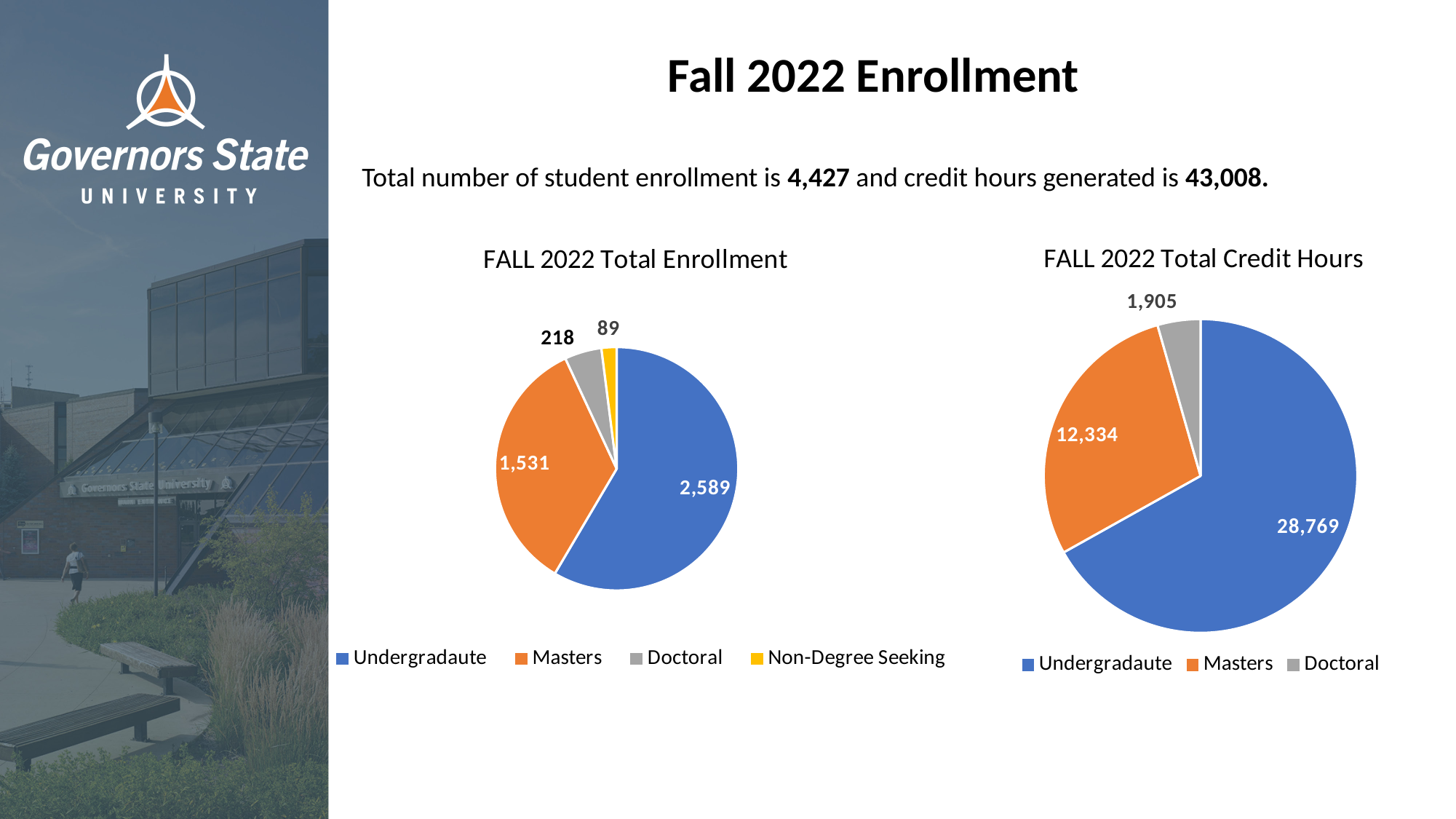
In the FALL 2022 Total Credit Hours chart, what is the value for Doctoral? 1,905 How many categories does the FALL 2022 Total Credit Hours chart show? 3 In the FALL 2022 Total Enrollment chart, what is the value for Masters? 1,531 How many categories does the FALL 2022 Total Enrollment chart show? 4 In the FALL 2022 Total Credit Hours chart, which category has the highest value? Undergradaute In the FALL 2022 Total Enrollment chart, what is the difference between the Undergradaute and Masters values? 1,058 In the FALL 2022 Total Enrollment chart, which is larger, Doctoral or Non-Degree Seeking? Doctoral In the FALL 2022 Total Credit Hours chart, what is the difference between the Undergradaute and Masters values? 16,435 What kind of chart is the FALL 2022 Total Credit Hours chart? Pie chart In the FALL 2022 Total Enrollment chart, what is the value for Non-Degree Seeking? 89 In the FALL 2022 Total Enrollment chart, which category has the lowest value? Non-Degree Seeking In the FALL 2022 Total Enrollment chart, what colour is the Masters slice? Orange